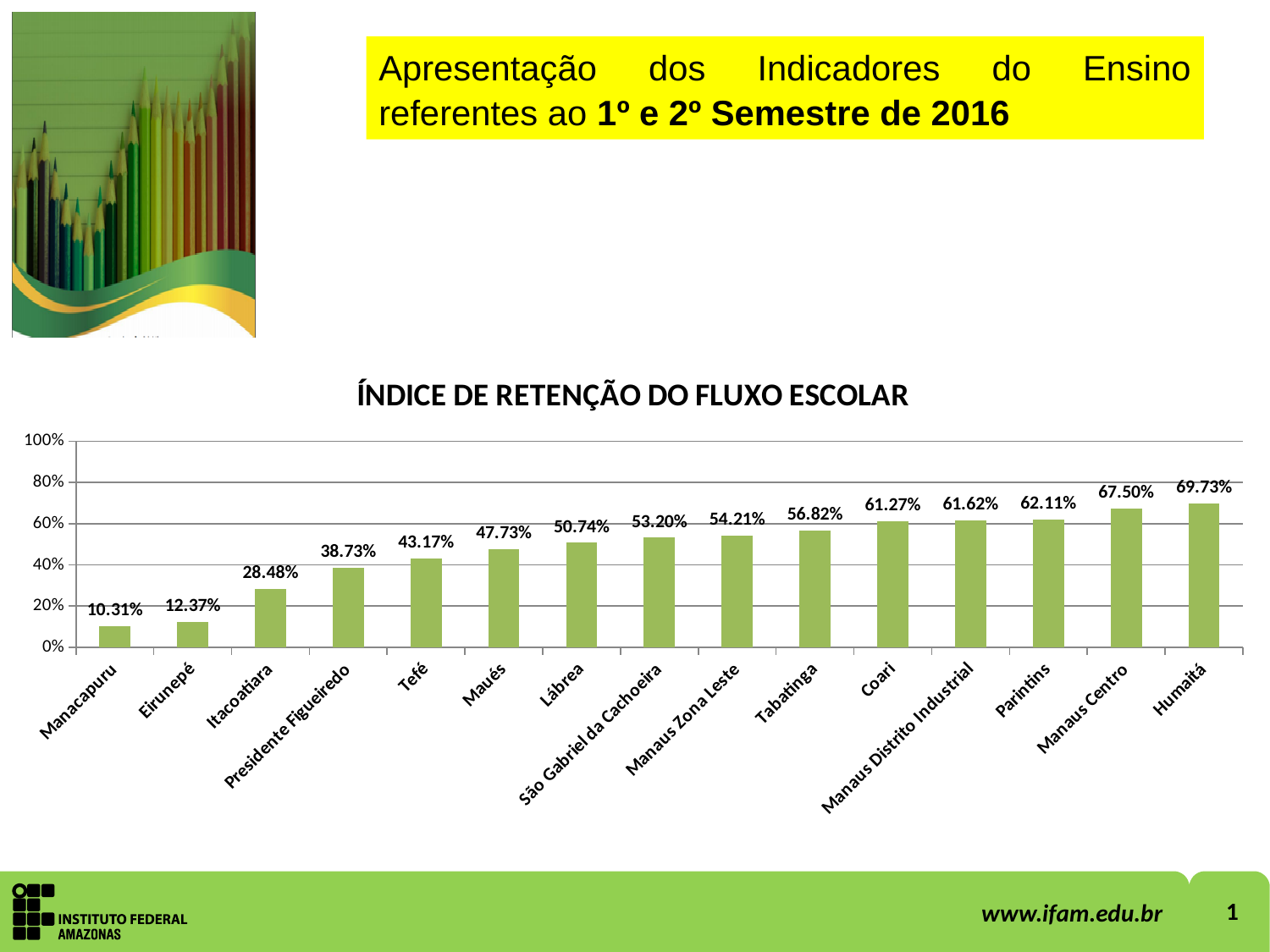
What is the value for Tefé? 43.17% What is the difference between the values for Humaitá and Manacapuru? 59.42% Which category has the lowest value? Manacapuru What is the difference between the values for Manaus Centro and Coari? 6.23% Is the value for Tabatinga greater or less than 40%? greater What is the value for Manaus Zona Leste? 54.21% What is the title of the chart? ÍNDICE DE RETENÇÃO DO FLUXO ESCOLAR How many categories are shown on the x axis? 15 What is the value for Parintins? 62.11% Which is larger, the value for Itacoatiara or the value for Presidente Figueiredo? Presidente Figueiredo Which category has the highest value? Humaitá What kind of chart is this? bar chart